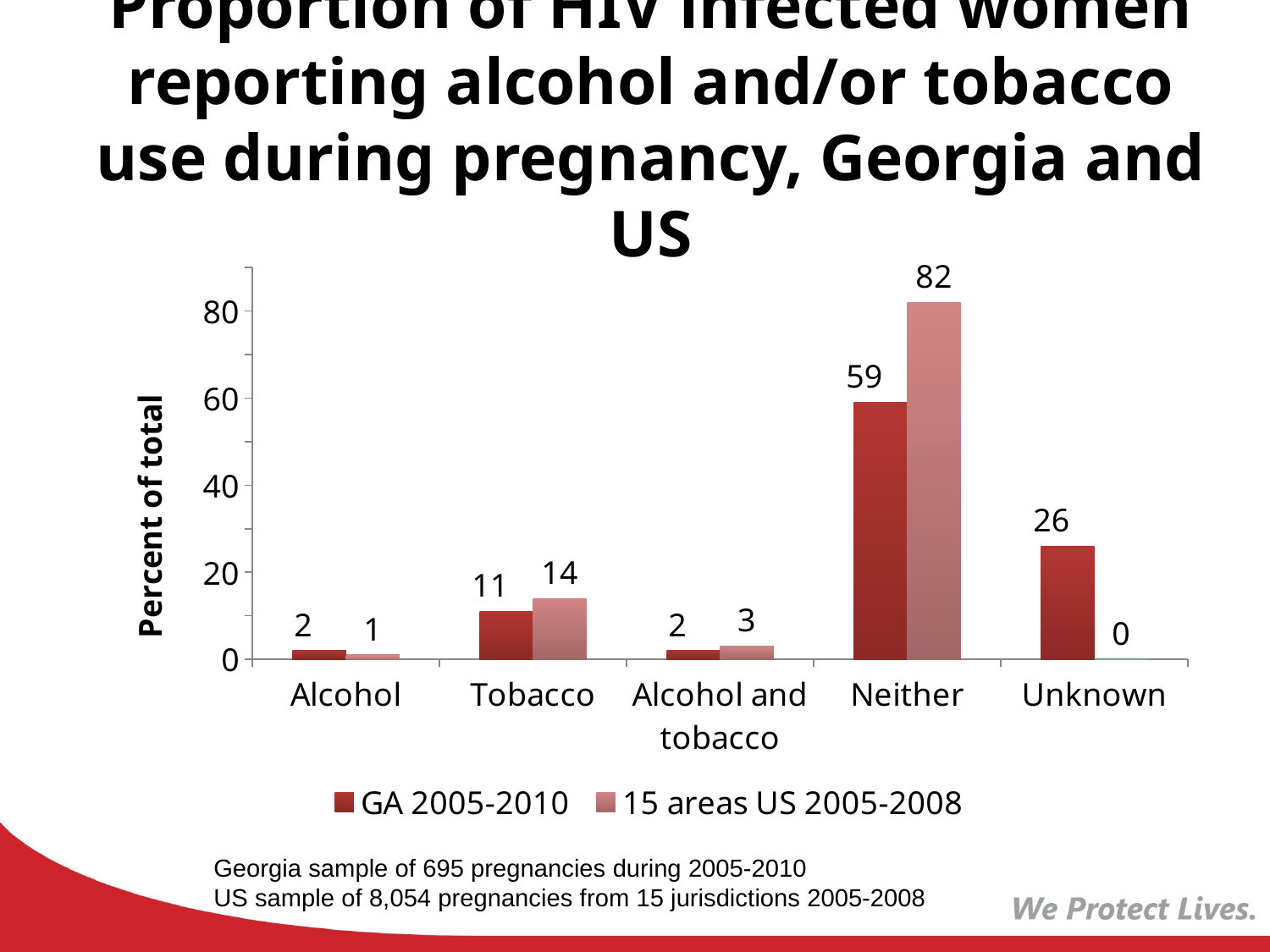
What is the value for GA 2005-2010 in the Unknown category? 26 Which category has the highest value for the 15 areas US 2005-2008 series? Neither How many categories are shown on the x axis? 5 In the Tobacco category, which series has the larger value, GA 2005-2010 or 15 areas US 2005-2008? 15 areas US 2005-2008 What is the label of the y axis? Percent of total What is the value for 15 areas US 2005-2008 in the Tobacco category? 14 What is the value for 15 areas US 2005-2008 in the Alcohol category? 1 What is the value for GA 2005-2010 in the Neither category? 59 What kind of chart is shown on the slide? Bar chart Which category has the lowest value for the 15 areas US 2005-2008 series? Unknown How many series does the legend list? 2 What is the difference between the 15 areas US 2005-2008 and GA 2005-2010 values in the Neither category? 23